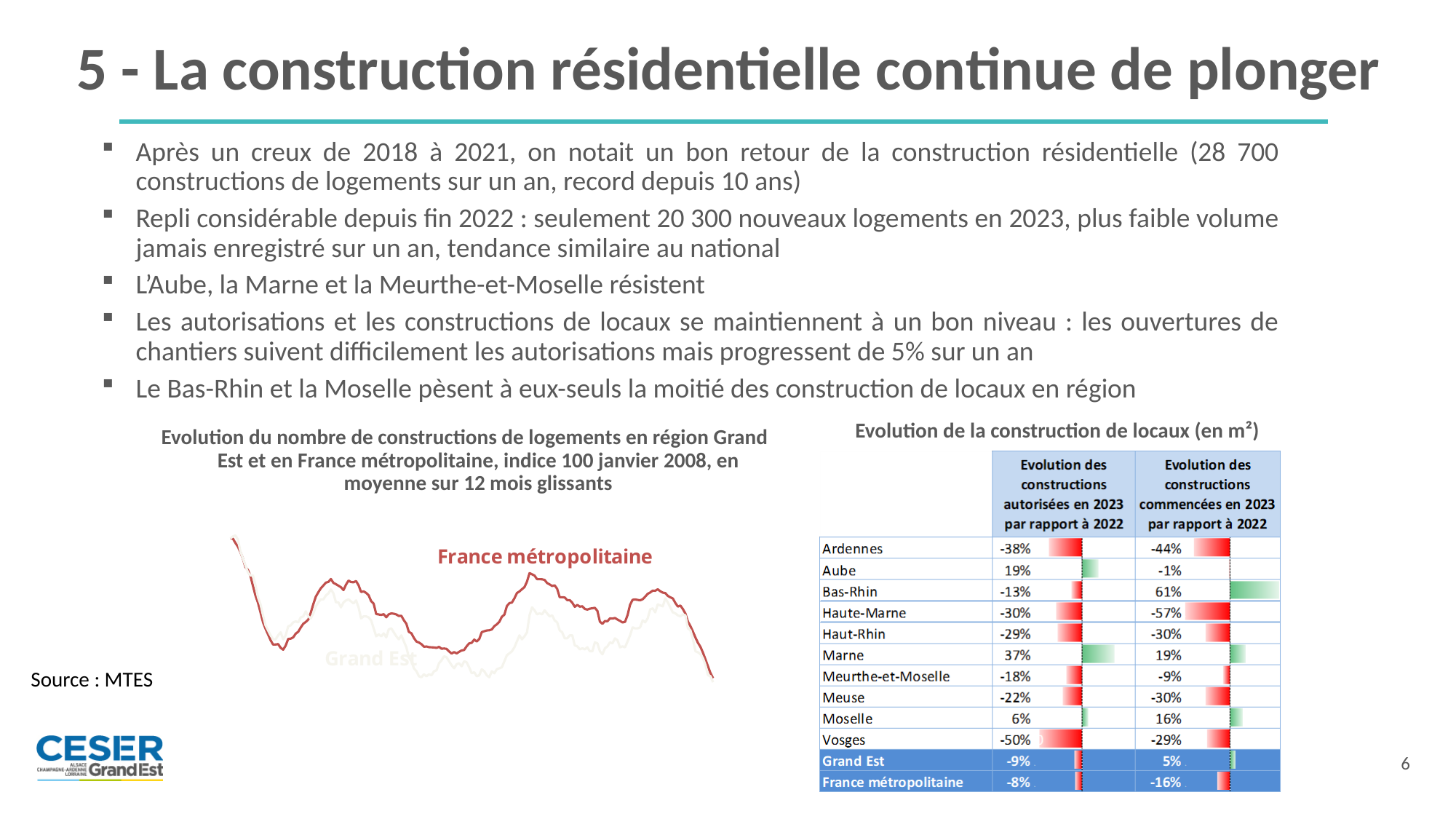
In the table 'Evolution de la construction de locaux (en m²)', what is the value for Vosges in the column 'Evolution des constructions autorisées en 2023 par rapport à 2022'? -50% In the table 'Evolution de la construction de locaux (en m²)', what is the difference in percentage points between Grand Est (5%) and France métropolitaine (-16%) for constructions commencées en 2023 par rapport à 2022? 21 percentage points What kind of chart is the chart on the left, titled 'Evolution du nombre de constructions de logements en région Grand Est et en France métropolitaine'? Line chart In the table 'Evolution de la construction de locaux (en m²)', which has the larger value for constructions autorisées en 2023 par rapport à 2022: Aube or Moselle? Aube In the line chart on the left, does the France métropolitaine line rise or fall at the right-hand end of the chart? Fall In the table 'Evolution de la construction de locaux (en m²)', what is the value for Grand Est in the column 'Evolution des constructions autorisées en 2023 par rapport à 2022'? -9% In the table 'Evolution de la construction de locaux (en m²)', which département has the highest value for constructions autorisées en 2023 par rapport à 2022? Marne In the line chart on the left, which series is drawn in red? France métropolitaine In the table 'Evolution de la construction de locaux (en m²)', what is the value for Bas-Rhin in the column 'Evolution des constructions commencées en 2023 par rapport à 2022'? 61% How many series are plotted in the line chart on the left? 2 How many départements (excluding the Grand Est and France métropolitaine rows) are listed in the table 'Evolution de la construction de locaux (en m²)'? 10 In the table 'Evolution de la construction de locaux (en m²)', which département has the lowest value for constructions commencées en 2023 par rapport à 2022? Haute-Marne